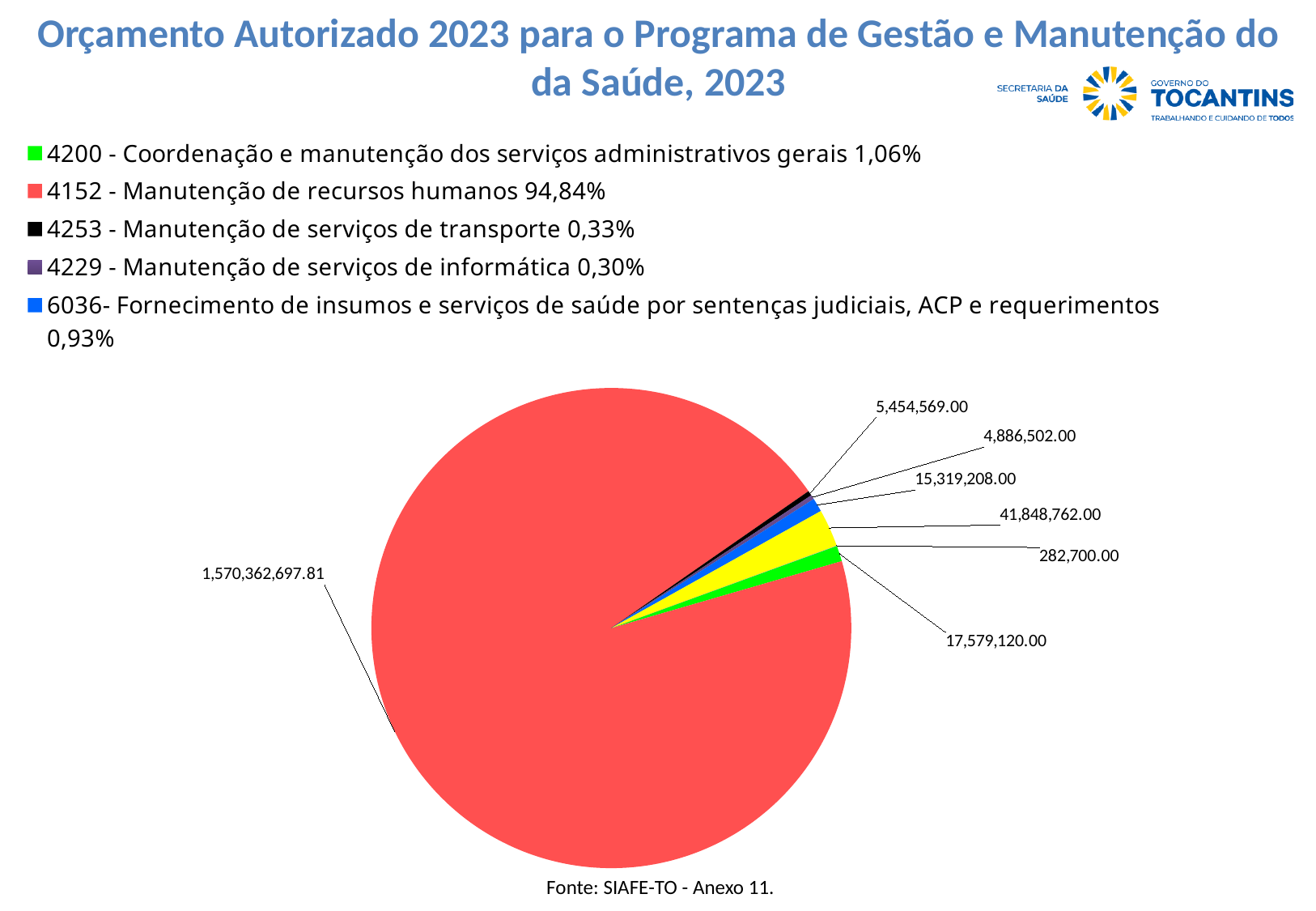
How many entries does the legend list? 5 What share of the pie does 4152 - Manutenção de recursos humanos represent, according to the legend? 94,84% What source is cited below the chart? Fonte: SIAFE-TO - Anexo 11. What type of chart is shown on the slide? Pie chart What is the value of the largest slice of the pie chart (the red slice, 4152 - Manutenção de recursos humanos)? 1,570,362,697.81 Which is larger: the black slice (5,454,569.00) or the purple slice (4,886,502.00)? The black slice (5,454,569.00) Which legend entry corresponds to the largest slice of the pie chart? 4152 - Manutenção de recursos humanos What is the difference between the green slice (17,579,120.00) and the blue slice (15,319,208.00)? 2,259,912.00 How many data labels are shown on the pie chart? 7 What is the smallest value labelled on the pie chart? 282,700.00 What is the value of the green slice (4200 - Coordenação e manutenção dos serviços administrativos gerais)? 17,579,120.00 What is the value of the blue slice (6036 - Fornecimento de insumos e serviços de saúde por sentenças judiciais, ACP e requerimentos)? 15,319,208.00